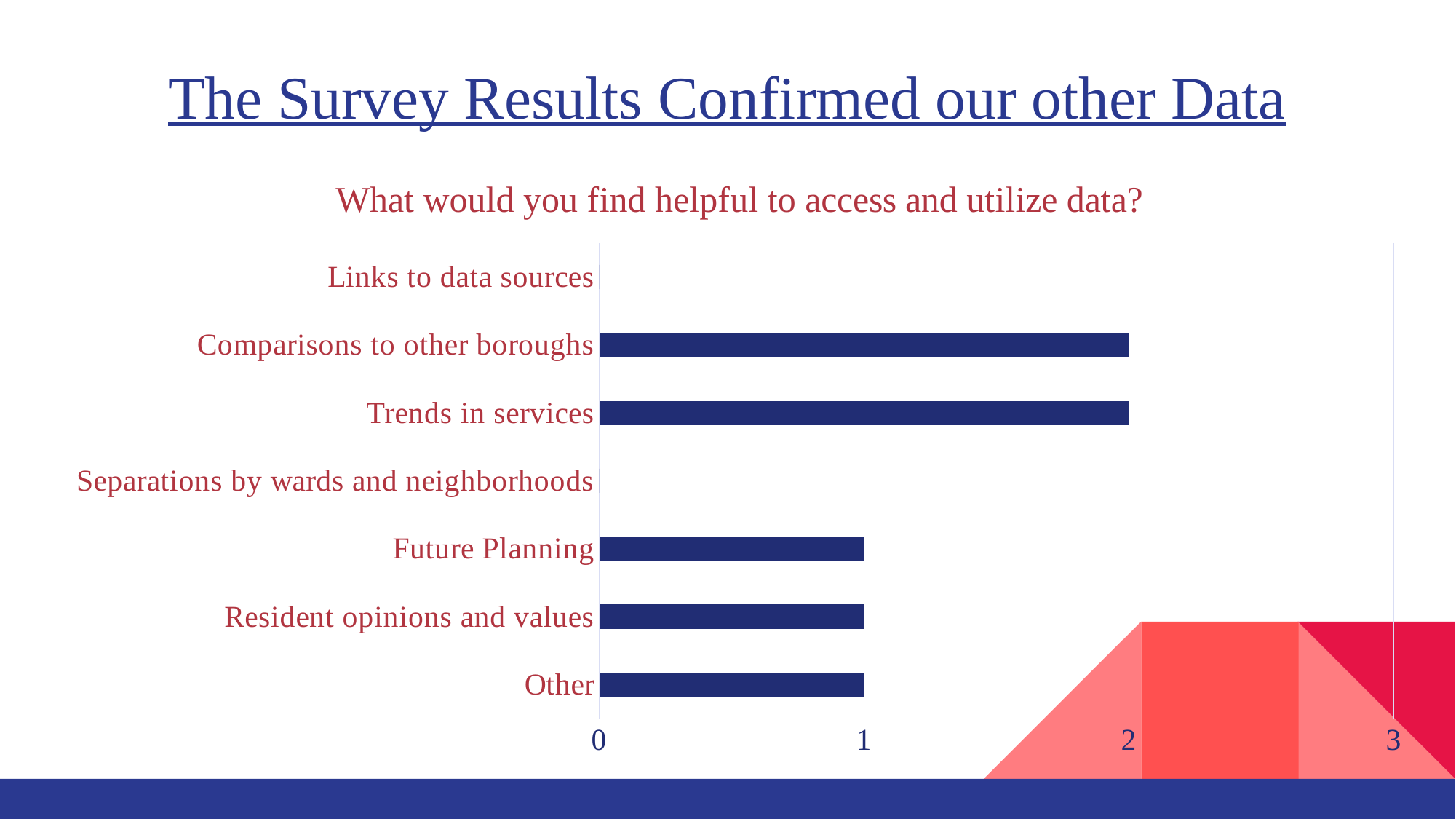
What is the title of the chart? What would you find helpful to access and utilize data? What is the value for Links to data sources? 0 What is the value for Trends in services? 2 Which is larger, the value for Trends in services or the value for Future Planning? Trends in services What is the value for Resident opinions and values? 1 How many categories are shown on the chart? 7 Is the value for Comparisons to other boroughs greater or less than 1? greater What is the value for Future Planning? 1 What is the value for Other? 1 What kind of chart is shown on the slide? bar chart What is the value for Comparisons to other boroughs? 2 What is the difference between the value for Comparisons to other boroughs and the value for Other? 1